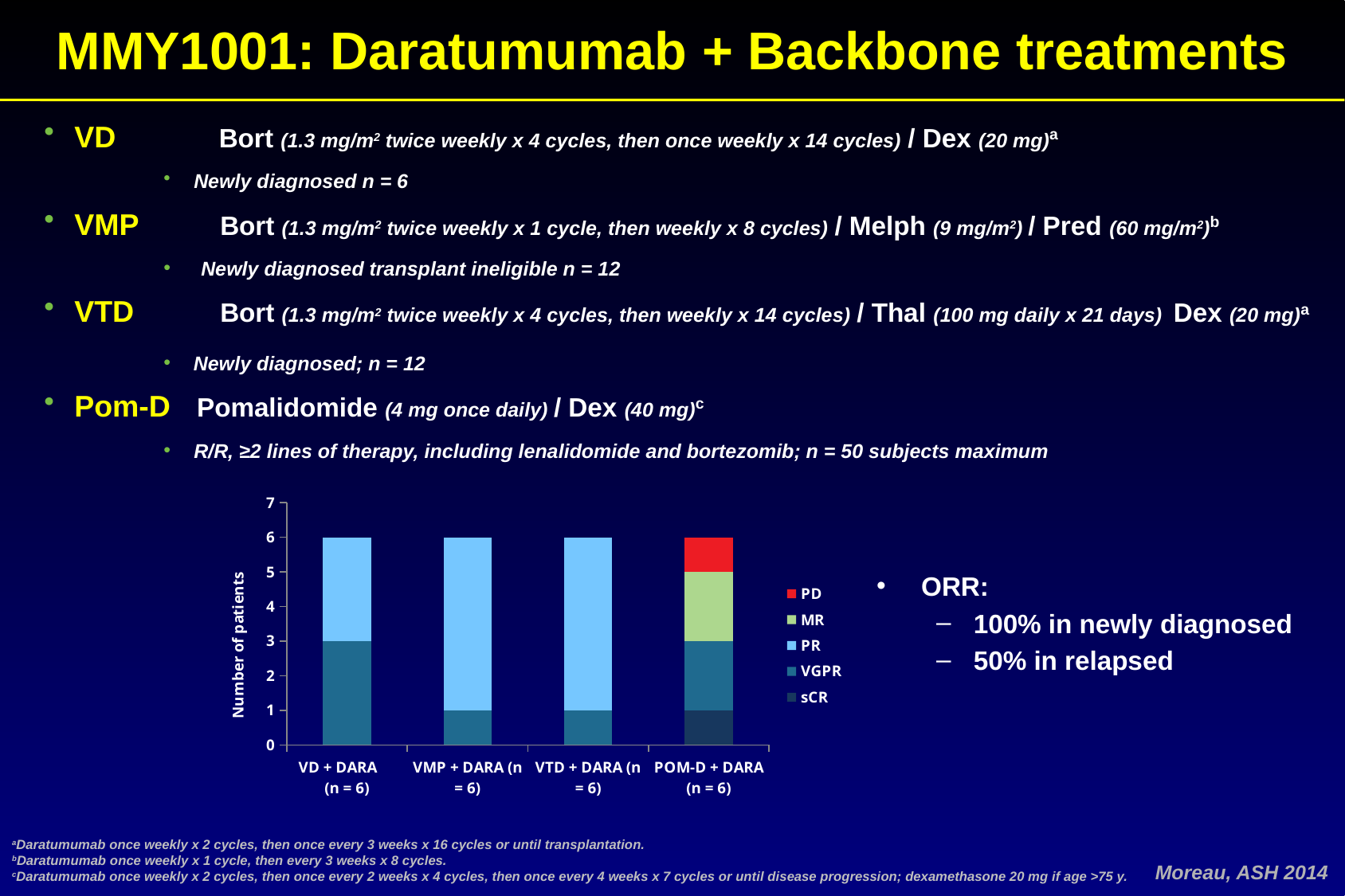
How many patients in the POM-D + DARA group had PD? 1 What is the total number of patients in the POM-D + DARA bar? 6 Which is larger: the number of VGPR patients in VD + DARA or in VMP + DARA? VD + DARA How many series does the chart legend list? 5 What kind of chart is shown on the slide? stacked bar chart How many patients in the VTD + DARA group achieved VGPR? 1 What is the total number of patients in the VD + DARA bar? 6 What is the axis title of the vertical axis of the chart? Number of patients How many patients in the VMP + DARA group achieved PR? 5 Which treatment group is the only one with patients in the PD category? POM-D + DARA How many patients in the VD + DARA group achieved VGPR? 3 How many treatment groups (categories) are shown on the x axis of the chart? 4